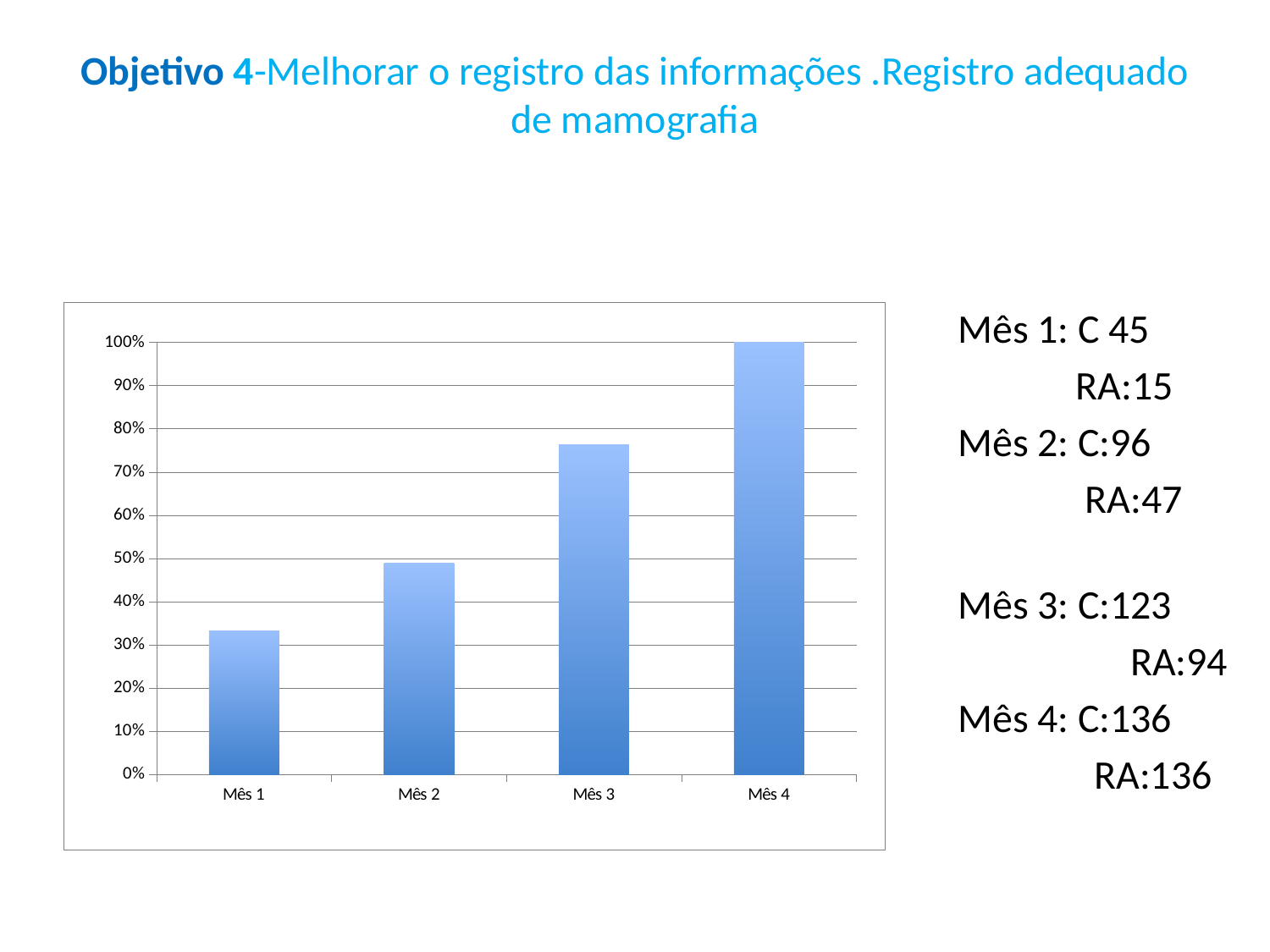
How many categories (months) are plotted on the chart? 4 Which month has the highest bar on the chart? Mês 4 Is the value for Mês 1 greater or less than 40%? less Is the value for Mês 2 greater or less than 60%? less Is the value for Mês 3 greater or less than 80%? less Do the values rise or fall from Mês 1 to Mês 4? rise Which is larger, the value for Mês 2 or the value for Mês 3? Mês 3 Which month has the lowest bar on the chart? Mês 1 What is the value for Mês 4 on the chart? 100% What type of chart is shown on the slide? bar chart